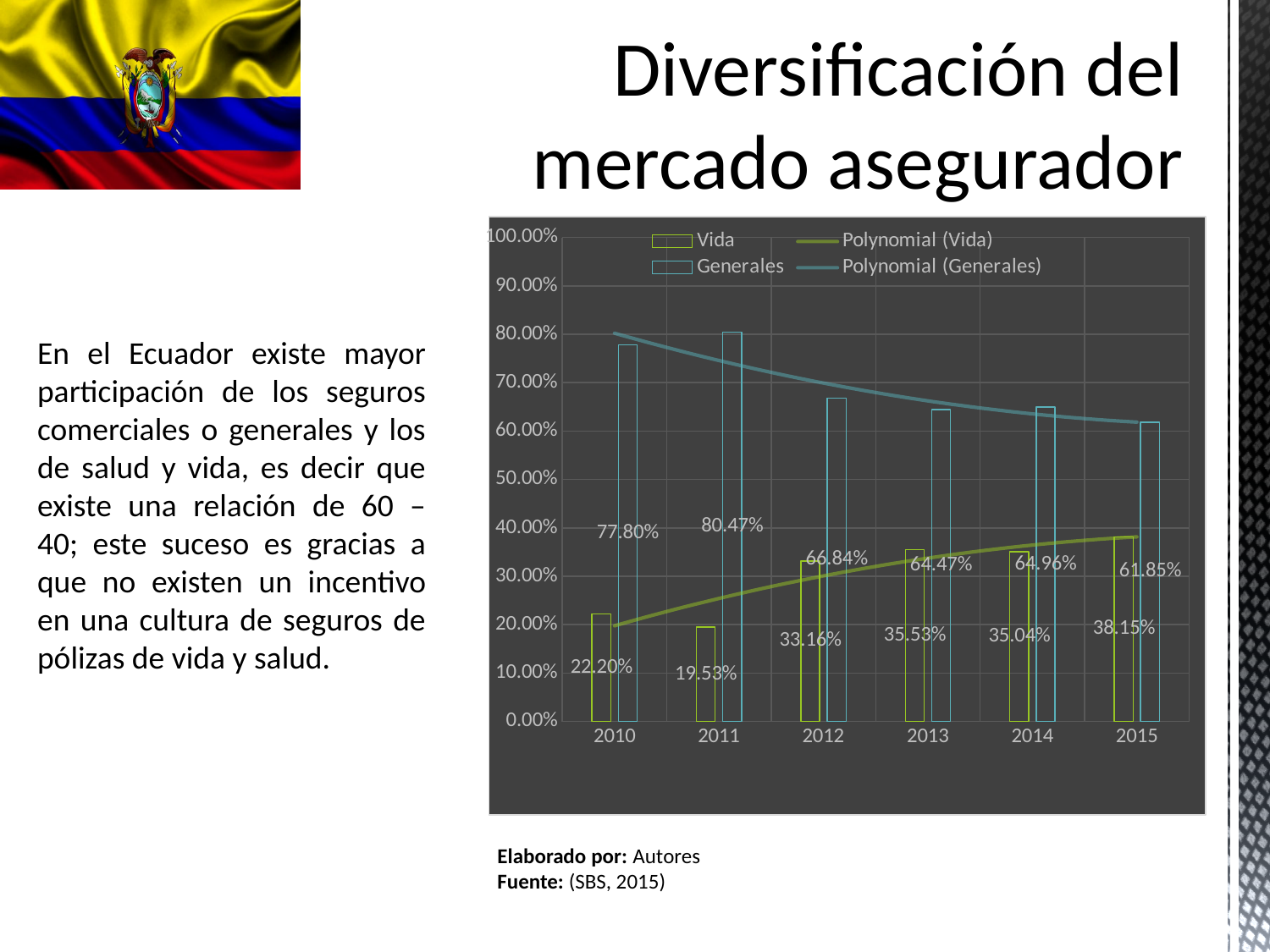
What kind of chart is shown on the slide? bar chart Is the value for Generales in 2015 greater or less than 60.00%? greater What is the value for Vida in 2015? 38.15% How many years are shown on the x axis? 6 Does the Generales value rise or fall from 2011 to 2015? fall How many entries does the legend list? 4 What is the difference between the Generales and Vida values in 2010? 55.60% In which year is the Vida value lowest? 2011 Which is larger in 2014, the Vida value or the Generales value? Generales What is the value for Generales in 2011? 80.47% In which year is the Generales value highest? 2011 What is the value for Vida in 2012? 33.16%